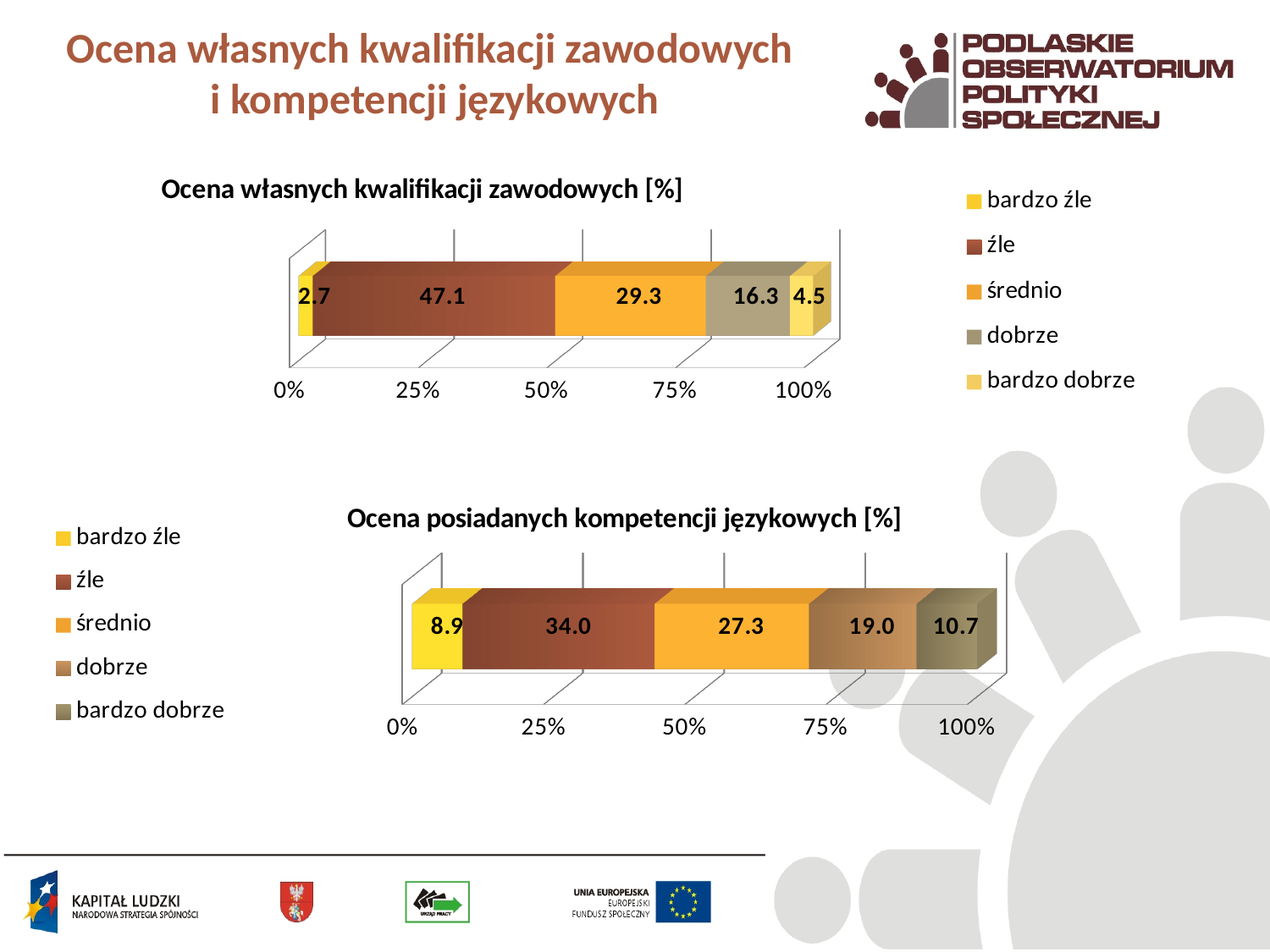
In the chart 'Ocena posiadanych kompetencji językowych [%]', what is the value for 'średnio'? 27.3 In the chart 'Ocena własnych kwalifikacji zawodowych [%]', which category has the highest value? źle How many series does the legend of the chart 'Ocena posiadanych kompetencji językowych [%]' list? 5 In the chart 'Ocena własnych kwalifikacji zawodowych [%]', which is larger, 'dobrze' or 'średnio'? średnio In the chart 'Ocena własnych kwalifikacji zawodowych [%]', what is the value for 'bardzo dobrze'? 4.5 In the chart 'Ocena własnych kwalifikacji zawodowych [%]', what is the value for 'źle'? 47.1 In the chart 'Ocena posiadanych kompetencji językowych [%]', what is the value for 'bardzo źle'? 8.9 In the chart 'Ocena posiadanych kompetencji językowych [%]', what is the difference between 'dobrze' and 'bardzo dobrze'? 8.3 In the chart 'Ocena posiadanych kompetencji językowych [%]', what is the difference between 'źle' and 'średnio'? 6.7 In the chart 'Ocena posiadanych kompetencji językowych [%]', which category has the lowest value? bardzo źle What kind of chart is 'Ocena własnych kwalifikacji zawodowych [%]'? stacked bar chart In the chart 'Ocena własnych kwalifikacji zawodowych [%]', which category has the lowest value? bardzo źle